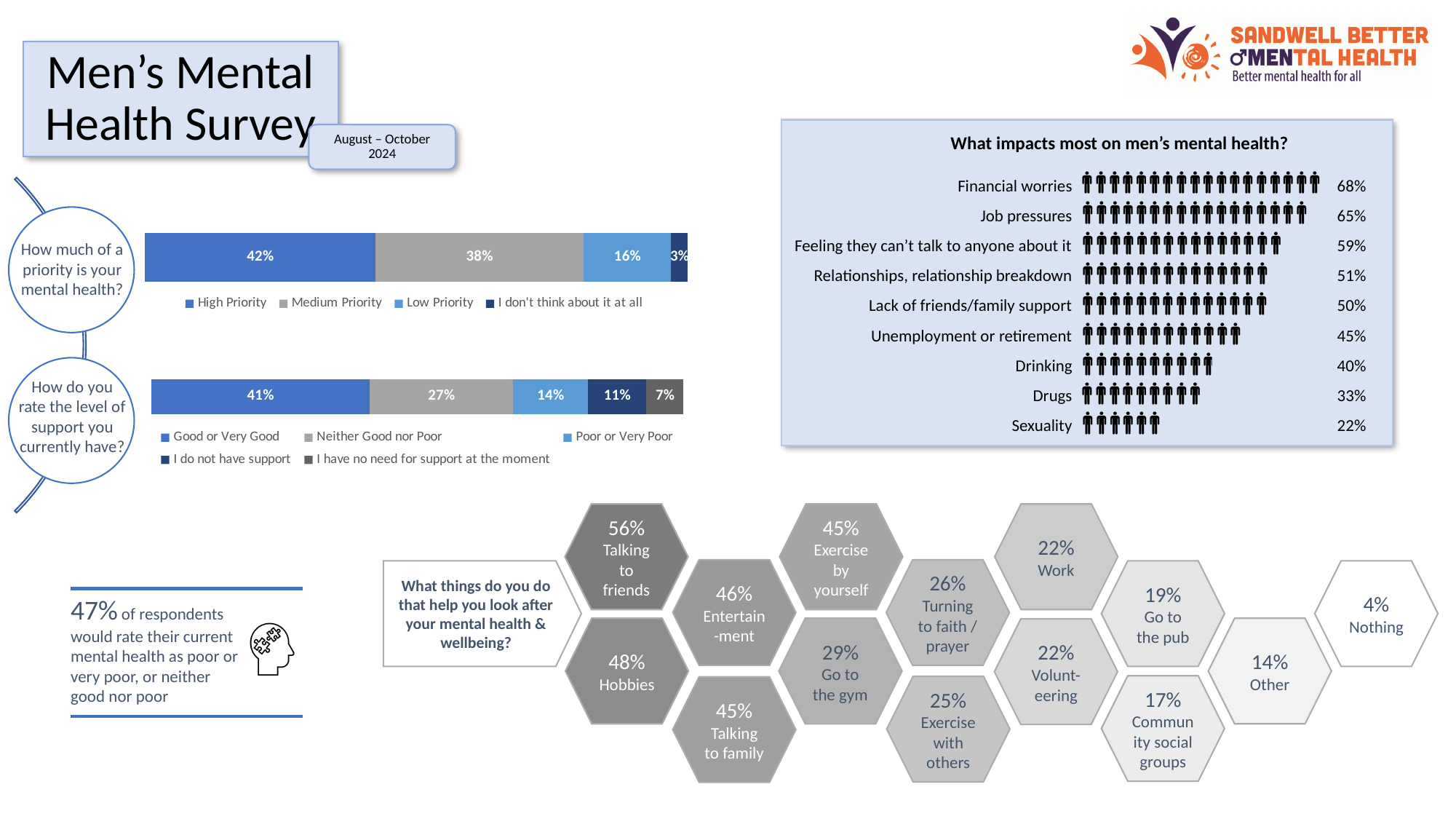
In the chart 'What impacts most on men's mental health?', which factor has the highest percentage? Financial worries In the chart 'How much of a priority is your mental health?', what is the difference between the High Priority and Medium Priority percentages? 4% In the chart 'What impacts most on men's mental health?', which factor has the lowest percentage? Sexuality What kind of chart is used for 'How much of a priority is your mental health?' Stacked bar chart In the chart 'How much of a priority is your mental health?', what percentage of respondents said High Priority? 42% In the chart 'How much of a priority is your mental health?', what percentage said they don't think about it at all? 3% How many series does the legend list for the chart 'How do you rate the level of support you currently have?' 5 In the chart 'How do you rate the level of support you currently have?', what percentage said 'I do not have support'? 11% In the chart 'How do you rate the level of support you currently have?', what percentage said Good or Very Good? 41% In the chart 'What impacts most on men's mental health?', what percentage is shown for Drinking? 40% In the chart 'How do you rate the level of support you currently have?', which is larger: Neither Good nor Poor or Poor or Very Poor? Neither Good nor Poor How many series does the legend list for the chart 'How much of a priority is your mental health?' 4